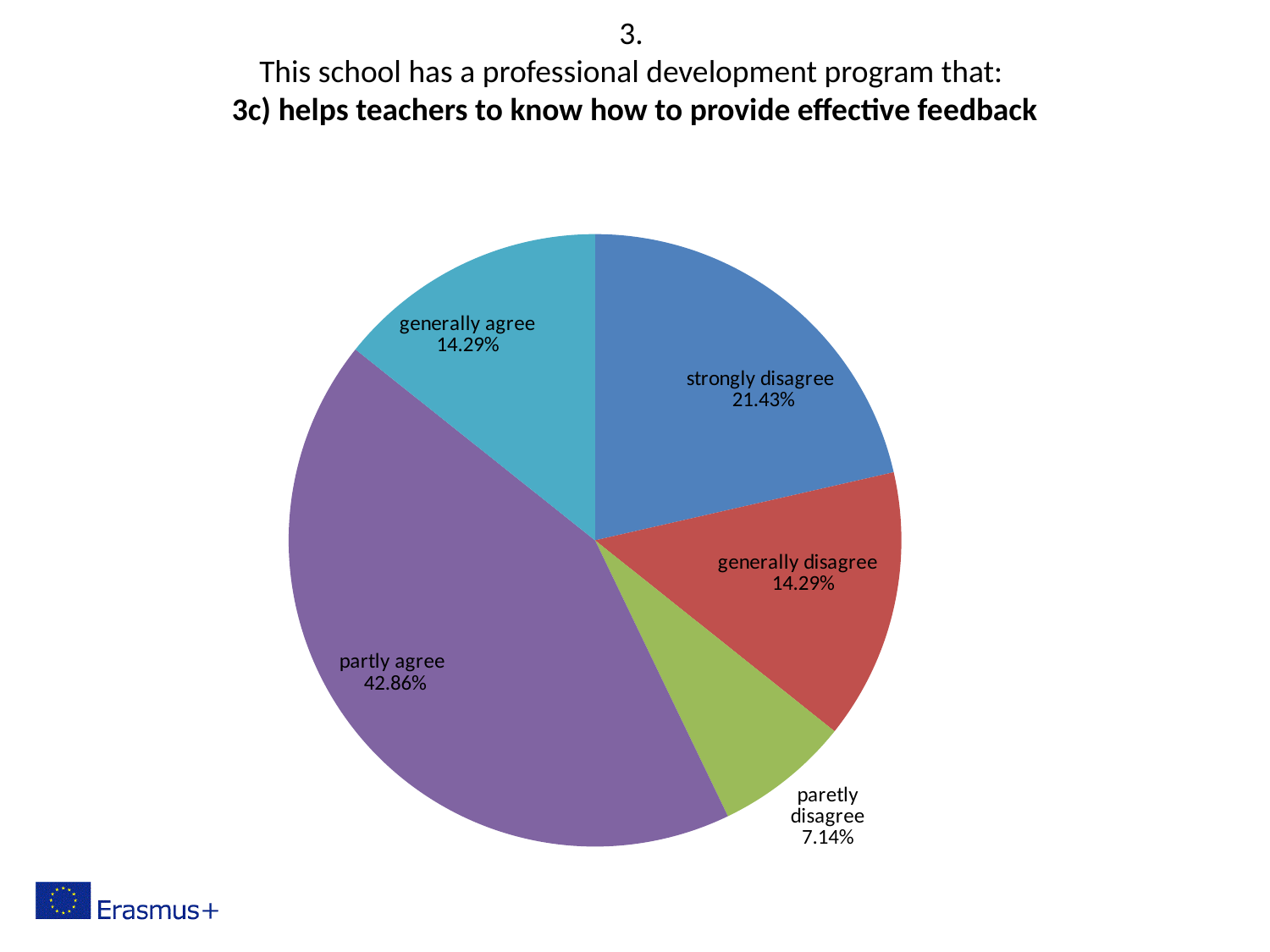
Which slice of the pie is the smallest? paretly disagree What share of the pie is labelled 'strongly disagree'? 21.43% What colour is the 'partly agree' slice? purple What share of the pie is labelled 'partly agree'? 42.86% What is the difference between the 'partly agree' and 'strongly disagree' shares? 21.43% What share of the pie is labelled 'generally agree'? 14.29% What kind of chart is shown on the slide? pie chart How many slices does the pie chart have? 5 Which slice of the pie is the largest? partly agree What share of the pie is labelled 'paretly disagree'? 7.14% Which is larger, the 'strongly disagree' slice or the 'generally disagree' slice? strongly disagree What is the combined share of 'generally agree' and 'generally disagree'? 28.58%